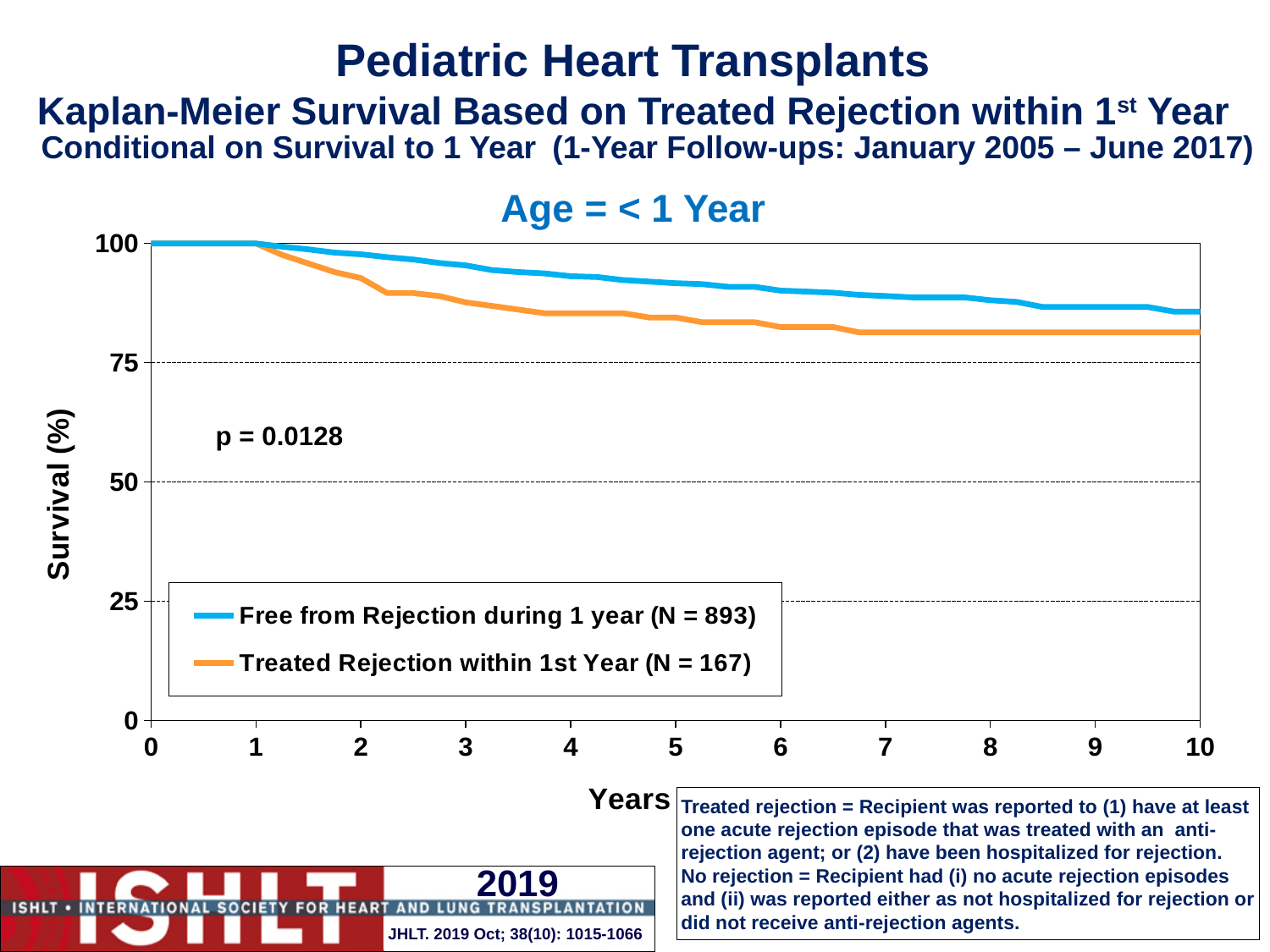
What kind of chart is shown on the slide? Line chart What is the age group subtitle shown above the chart? Age = < 1 Year Do the survival curves rise or fall as years increase along the x axis? Fall What p-value is printed on the chart? p = 0.0128 Is the survival value for the Treated Rejection within 1st Year group at year 3 greater or less than 100? less What is the N for the Treated Rejection within 1st Year group shown in the legend? 167 Is the survival value for the Free from Rejection during 1 year group at year 10 greater or less than 75? greater Is the survival value for the Treated Rejection within 1st Year group at year 10 greater or less than 75? greater At year 5, which group has higher survival: Free from Rejection during 1 year or Treated Rejection within 1st Year? Free from Rejection during 1 year What is the N for the Free from Rejection during 1 year group shown in the legend? 893 What is the label on the y axis of the chart? Survival (%) How many series does the legend list? 2